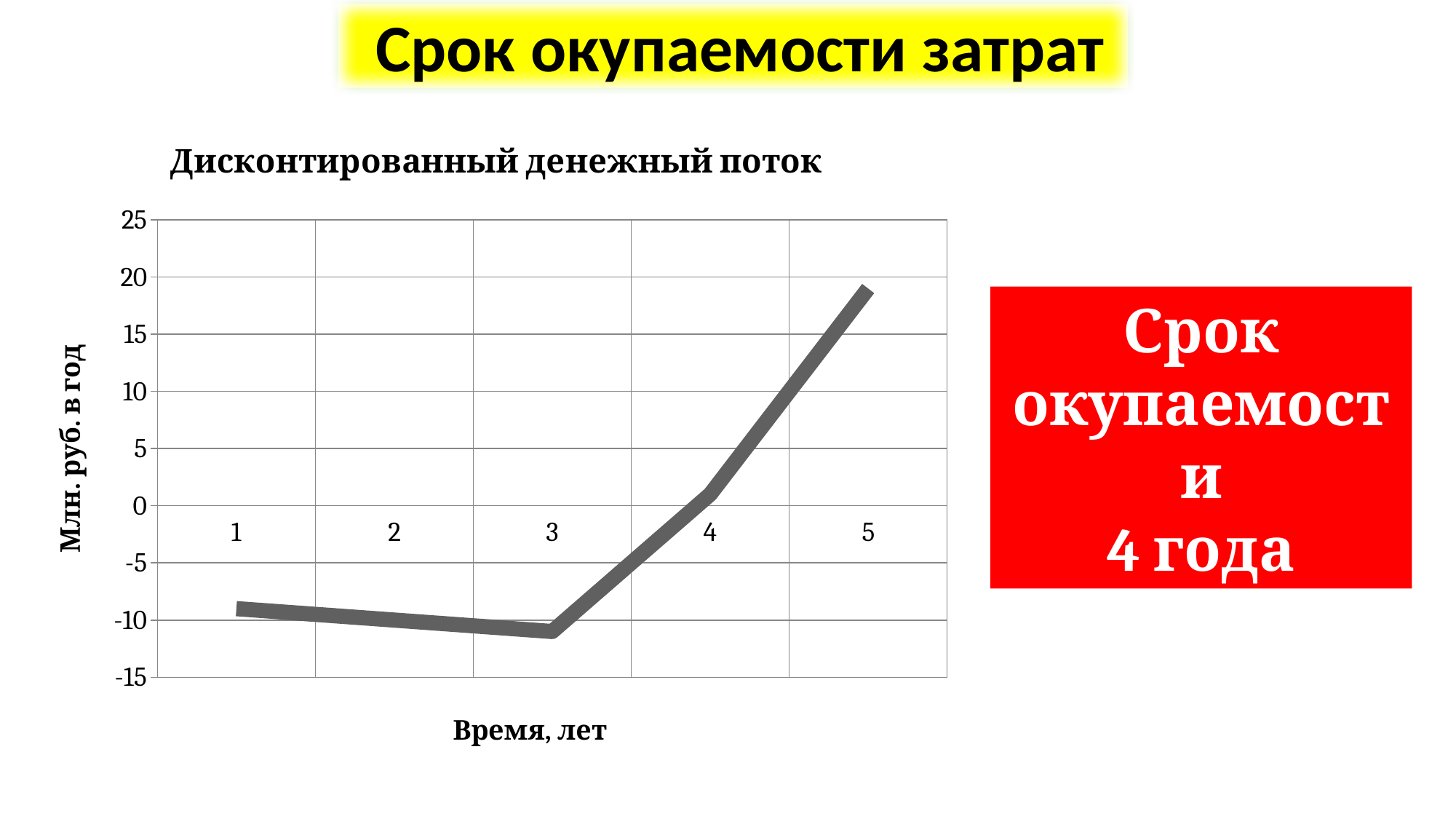
What is the label of the vertical axis of the chart? Млн. руб. в год Is the value for year 5 greater or less than 15? greater How many points (years) are plotted on the chart? 5 In which year is the discounted cash flow highest? 5 Which is larger, the value for year 4 or the value for year 3? year 4 What kind of chart is shown on the slide? line chart What is the title of the chart? Дисконтированный денежный поток Is the value for year 2 greater or less than -5? less Is the value for year 1 greater or less than -5? less In which year is the discounted cash flow lowest? 3 Between year 3 and year 5, does the discounted cash flow rise or fall? rise